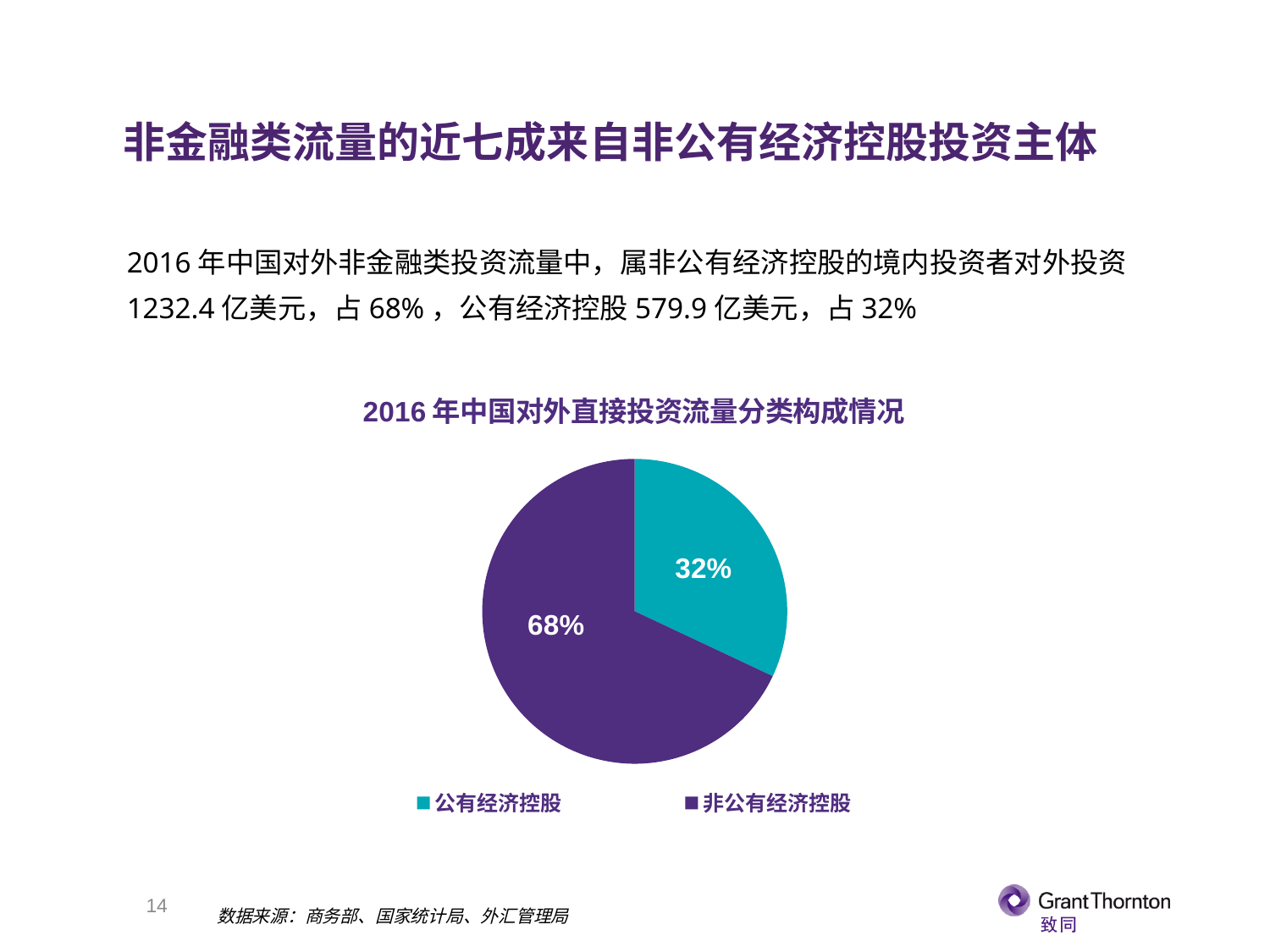
What share of the pie does 公有经济控股 account for? 32% How many slices does the pie chart have? 2 What is the title of the chart? 2016 年中国对外直接投资流量分类构成情况 Which category has the largest slice of the pie? 非公有经济控股 What kind of chart is shown on the slide? Pie chart Which is larger, the slice for 公有经济控股 or the slice for 非公有经济控股? 非公有经济控股 Which category has the smallest slice of the pie? 公有经济控股 How many entries does the legend list? 2 What share of the pie does 非公有经济控股 account for? 68% What is the difference in percentage points between the 非公有经济控股 and 公有经济控股 slices? 36 Which category is shown in purple in the pie chart? 非公有经济控股